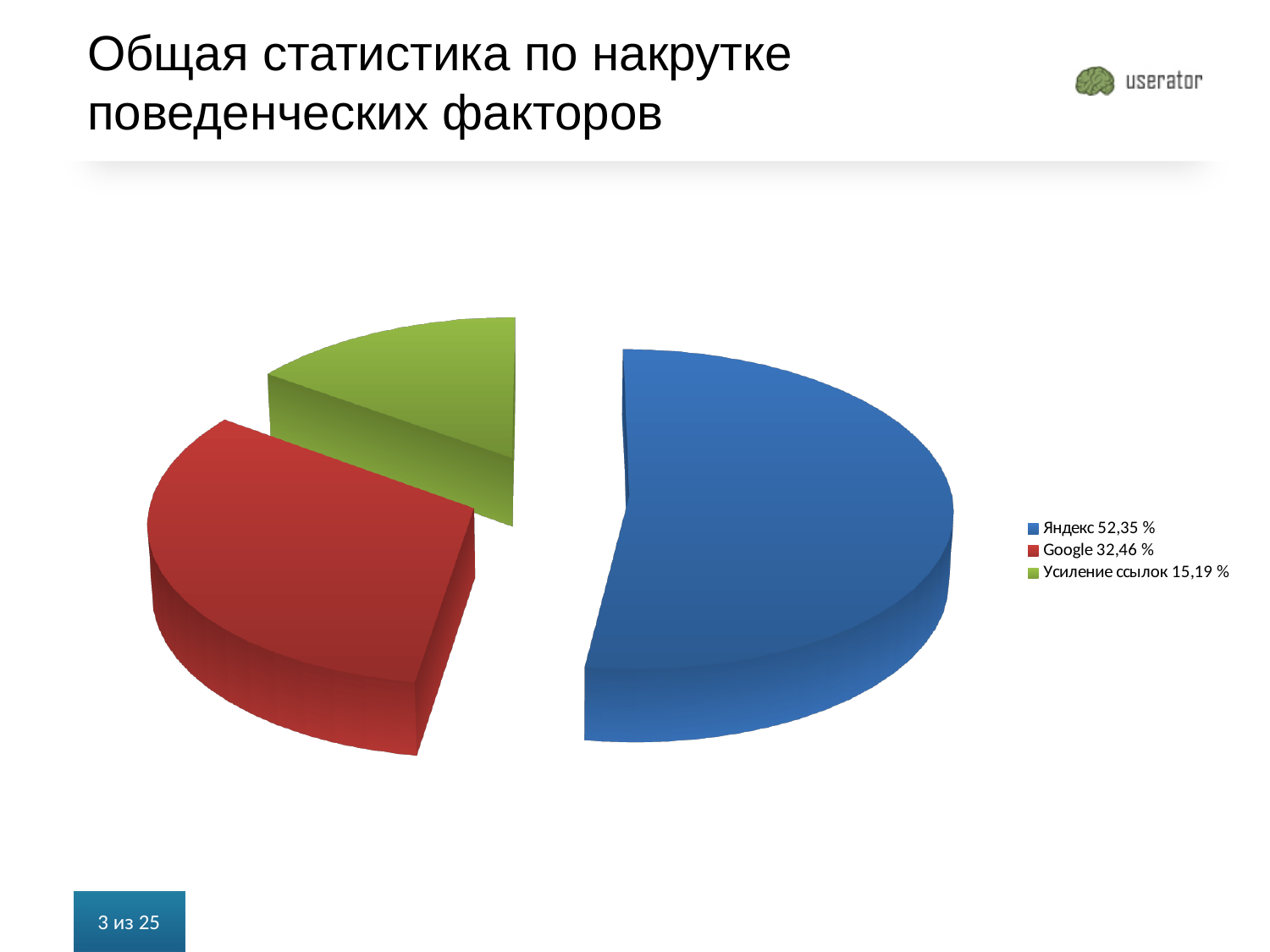
Which slice of the pie is the largest? Яндекс Which is larger, the share for Google or the share for Усиление ссылок? Google What share of the pie does Усиление ссылок have? 15,19 % How many slices does the pie chart have? 3 What kind of chart is shown on the slide? Pie chart What colour is the Google slice? Red What colour is the Яндекс slice? Blue What is the difference in percentage points between the Яндекс share and the Google share? 19,89 What share of the pie does Google have? 32,46 % Which slice of the pie is the smallest? Усиление ссылок What share of the pie does Яндекс have? 52,35 % How many entries does the legend list? 3